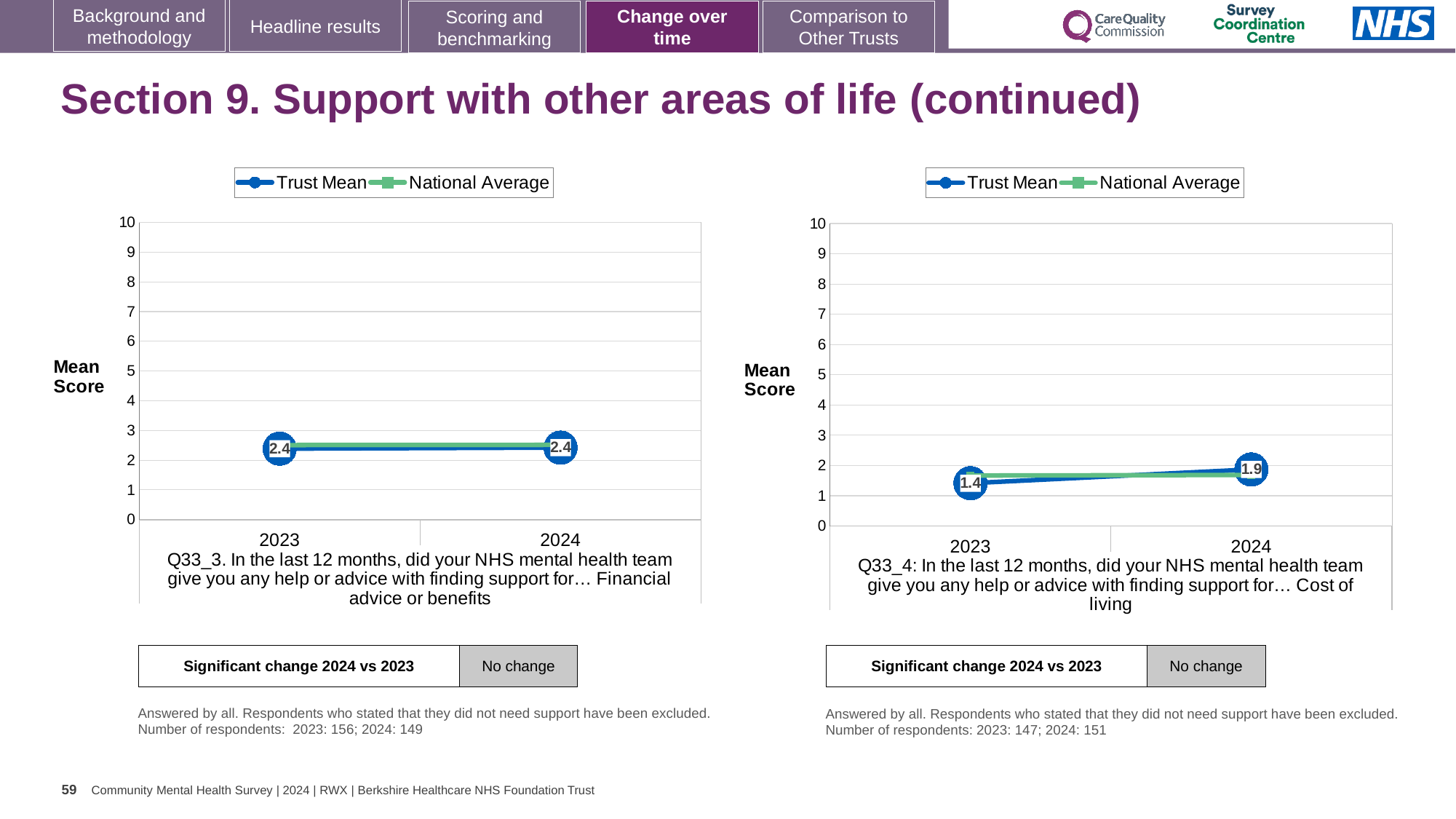
How many series does the legend of the left chart (Q33_3) list? 2 On the right chart (Q33_4, Cost of living), which year has the higher Trust Mean, 2023 or 2024? 2024 On the right chart (Q33_4, Cost of living), does the Trust Mean rise or fall from 2023 to 2024? rise On the right chart (Q33_4, Cost of living), what is the Trust Mean for 2023? 1.4 On the left chart (Q33_3, Financial advice or benefits), what is the Trust Mean for 2024? 2.4 What kind of chart is the left chart (Q33_3, Financial advice or benefits)? line chart What is the y-axis label on the right chart (Q33_4, Cost of living)? Mean Score On the left chart (Q33_3, Financial advice or benefits), what is the Trust Mean for 2023? 2.4 How many years are plotted on the x axis of the right chart (Q33_4)? 2 On the right chart (Q33_4, Cost of living), what is the difference between the Trust Mean for 2024 and 2023? 0.5 On the left chart (Q33_3, Financial advice or benefits), is the Trust Mean for 2024 greater or less than 5? less On the right chart (Q33_4, Cost of living), what is the Trust Mean for 2024? 1.9